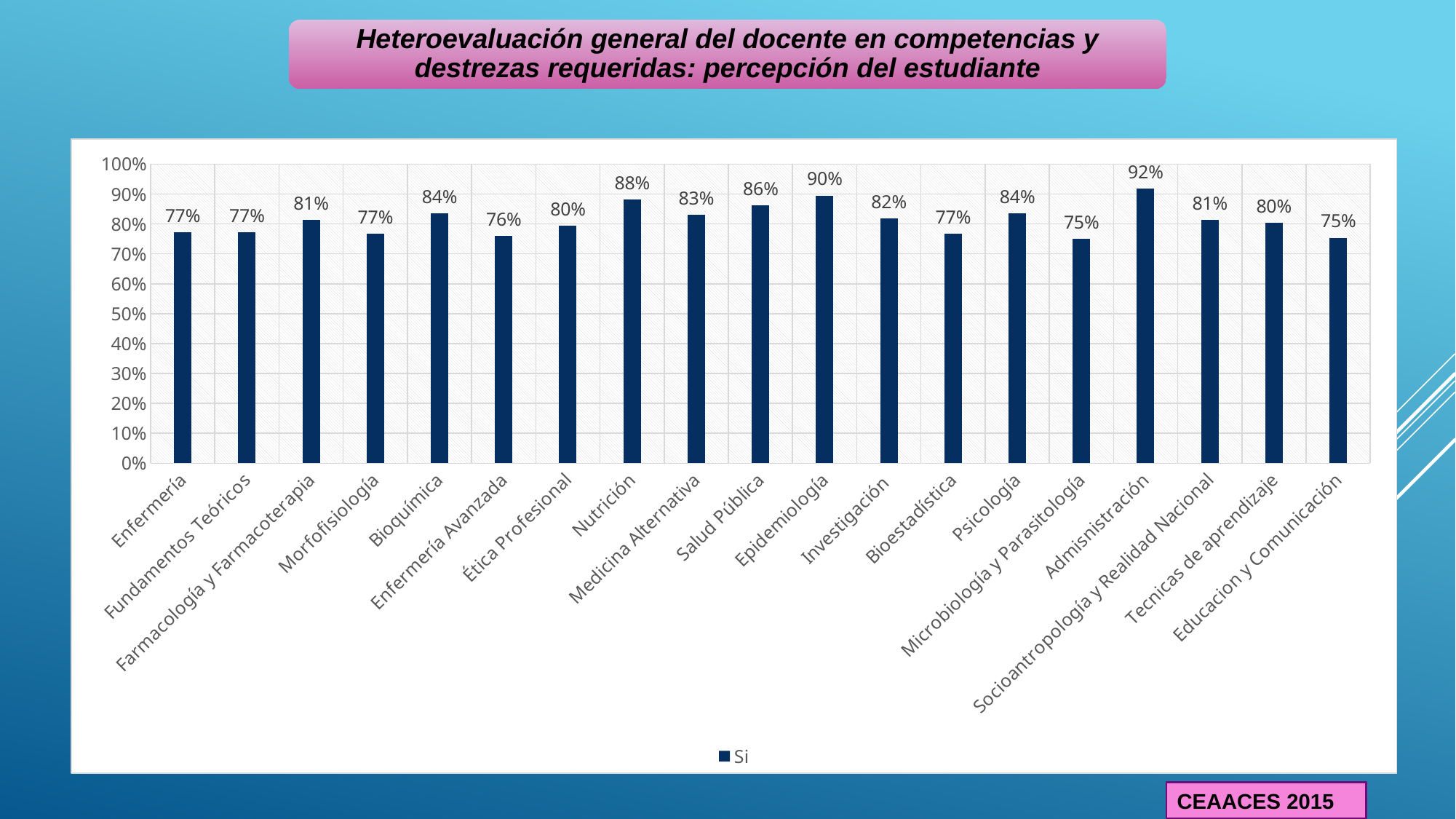
What is the difference between the values for Adminsistración and Microbiología y Parasitología? 17% What type of chart is shown on the slide? bar chart How many categories are shown on the x axis? 19 Which is larger, the value for Bioquímica or the value for Investigación? Bioquímica Which category has the highest value? Adminsistración Is the value for Ética Profesional greater or less than 70%? greater What is the value for Nutrición? 88% What is the value for Salud Pública? 86% What is the value for Enfermería Avanzada? 76% How many series does the legend list? 1 What is the legend entry for the series shown? Si What is the value for Epidemiología? 90%